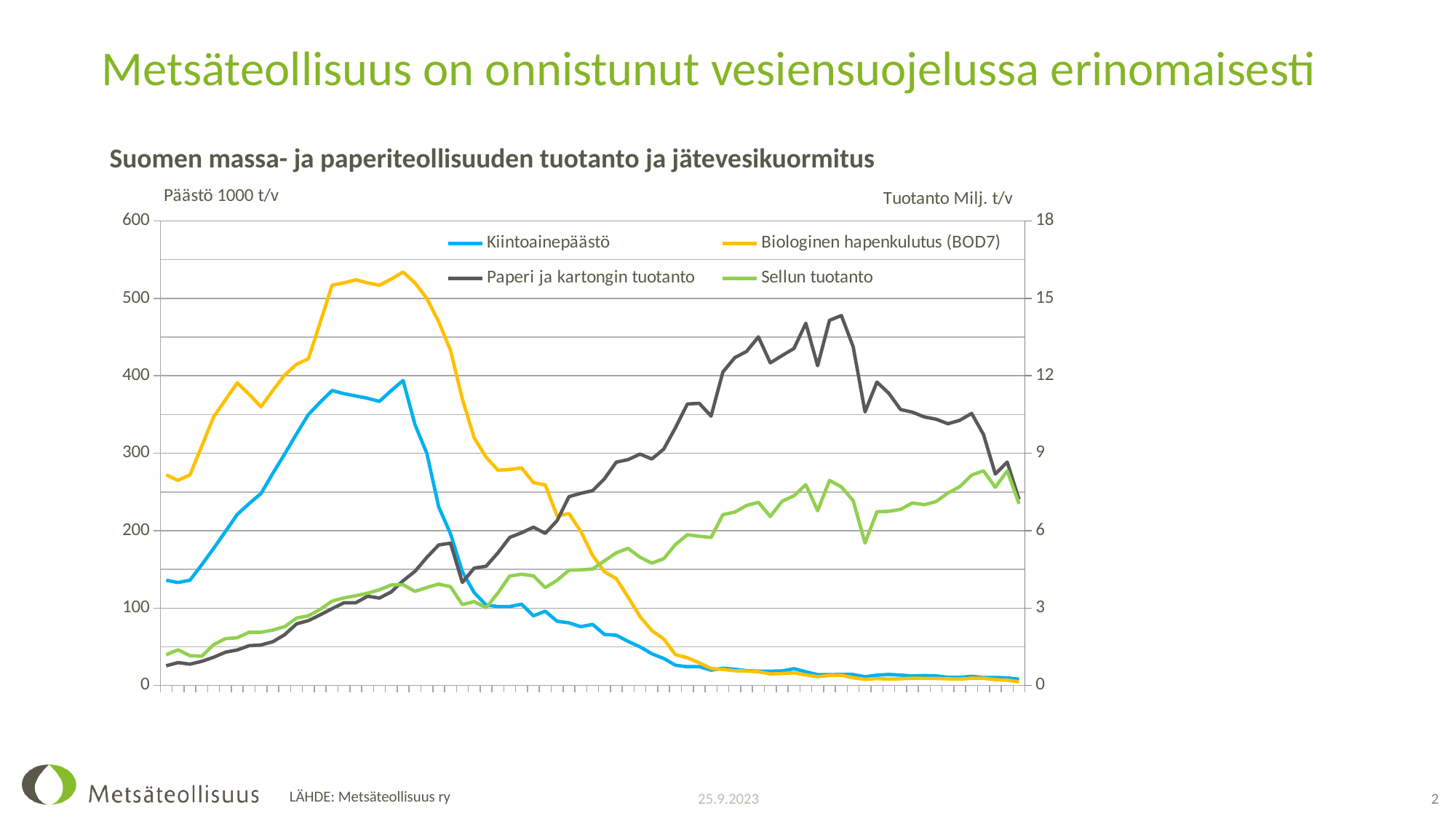
What is the label of the right-hand vertical axis? Tuotanto Milj. t/v Which of the two emission series, Kiintoainepäästö or Biologinen hapenkulutus (BOD7), reaches the higher peak on the left axis? Biologinen hapenkulutus (BOD7) Does the Kiintoainepäästö series rise or fall from its peak to the right end of the chart? fall How many series does the chart legend list? 4 Is the peak value of Sellun tuotanto on the right axis greater or less than 9? less Is the value of Kiintoainepäästö at the right end of the chart greater or less than 100? less What is the title of the chart? Suomen massa- ja paperiteollisuuden tuotanto ja jätevesikuormitus What kind of chart is shown on the slide? line chart Does the Paperi ja kartongin tuotanto series rise or fall overall from the left end of the chart to its peak? rise Is the peak value of Paperi ja kartongin tuotanto on the right axis greater or less than 12? greater